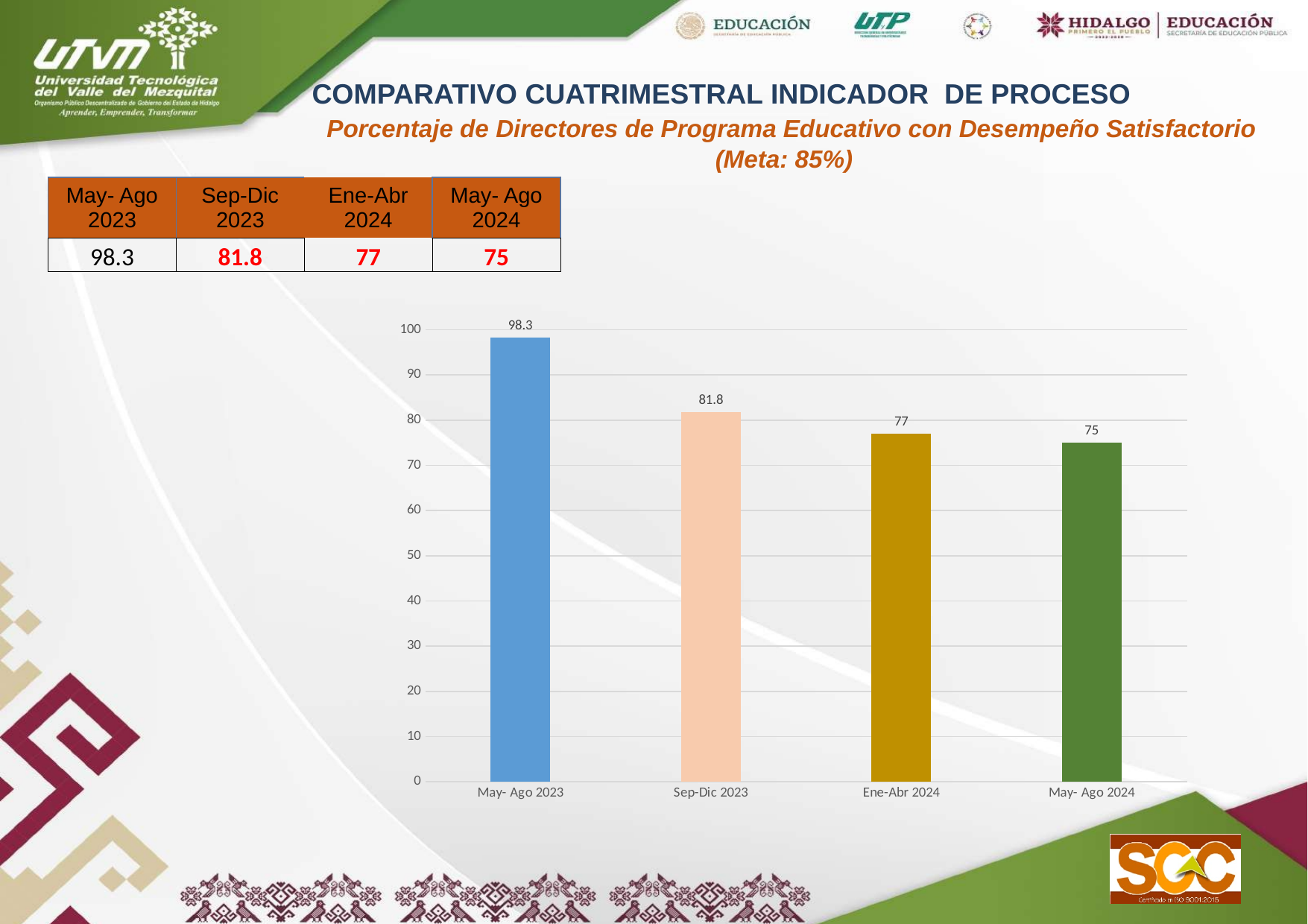
What is the value for Ene-Abr 2024? 77 Which period has the lowest value? May- Ago 2024 What kind of chart is shown on the slide? Bar chart How many periods are shown on the chart? 4 What is the value for Sep-Dic 2023? 81.8 What is the difference between the values for May- Ago 2023 and Sep-Dic 2023? 16.5 Which is larger, the value for Sep-Dic 2023 or the value for Ene-Abr 2024? Sep-Dic 2023 Which period has the highest value? May- Ago 2023 What is the difference between the values for Ene-Abr 2024 and May- Ago 2024? 2 What is the value for May- Ago 2024? 75 Do the values rise or fall from May- Ago 2023 to May- Ago 2024? Fall What is the value for May- Ago 2023? 98.3